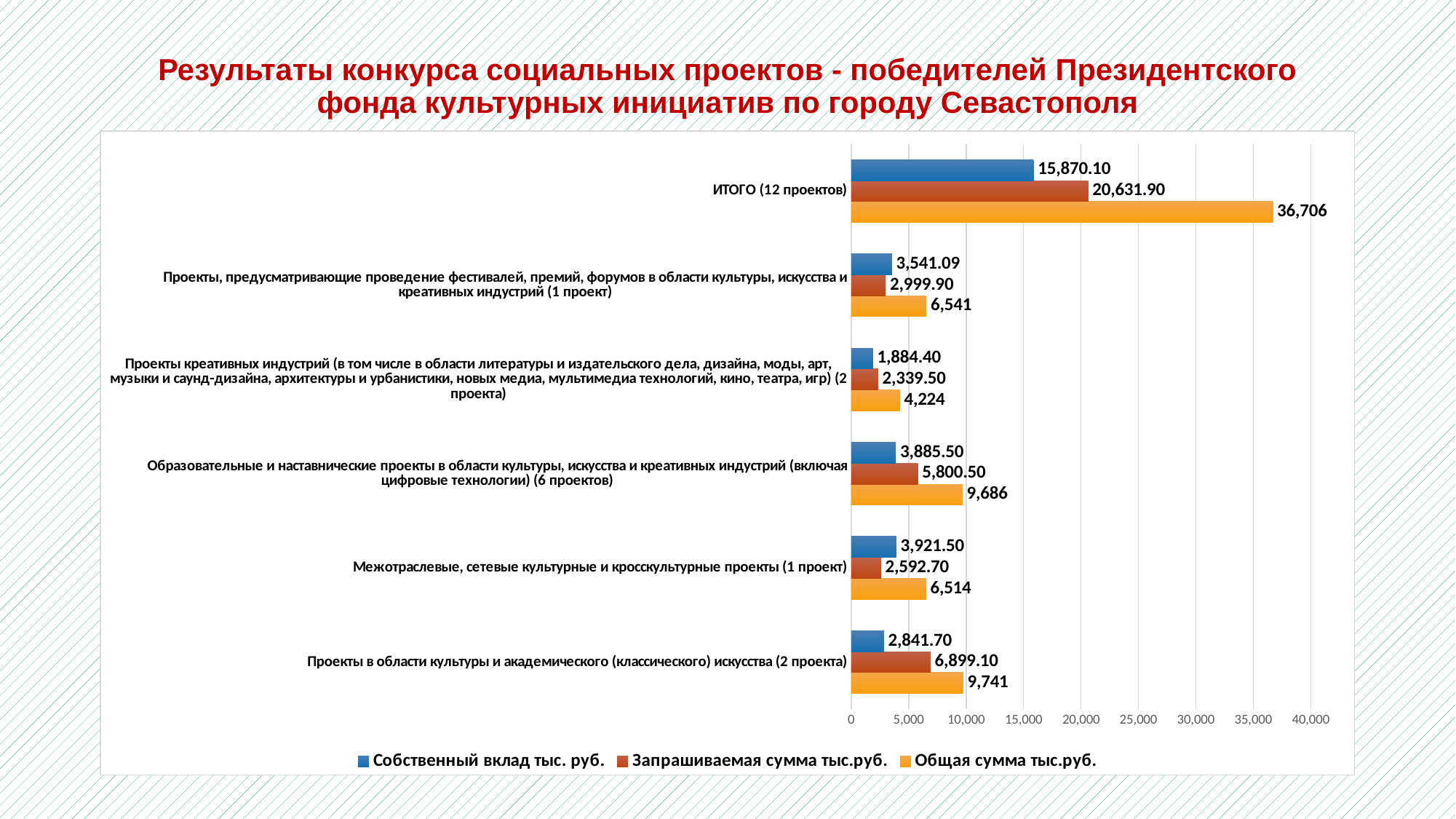
Which is larger for "Образовательные и наставнические проекты (6 проектов)": "Собственный вклад тыс. руб." or "Запрашиваемая сумма тыс.руб."? Запрашиваемая сумма тыс.руб. What is the value of "Собственный вклад тыс. руб." for "Межотраслевые, сетевые культурные и кросскультурные проекты (1 проект)"? 3,921.50 Excluding the "ИТОГО" row, which category has the highest "Общая сумма тыс.руб."? Проекты в области культуры и академического (классического) искусства (2 проекта) Is the "Общая сумма тыс.руб." for "ИТОГО (12 проектов)" greater or less than 35,000? greater How many categories are shown on the y axis of the chart? 6 What is the value of "Запрашиваемая сумма тыс.руб." for "Проекты в области культуры и академического (классического) искусства (2 проекта)"? 6,899.10 What kind of chart is shown on the slide? Bar chart Which colour represents "Общая сумма тыс.руб." in the chart? Orange What is the value of "Общая сумма тыс.руб." for "ИТОГО (12 проектов)"? 36,706 What is the difference between "Запрашиваемая сумма тыс.руб." and "Собственный вклад тыс. руб." for "ИТОГО (12 проектов)"? 4,761.80 How many series does the legend list? 3 Which category has the lowest "Собственный вклад тыс. руб."? Проекты креативных индустрий (2 проекта)